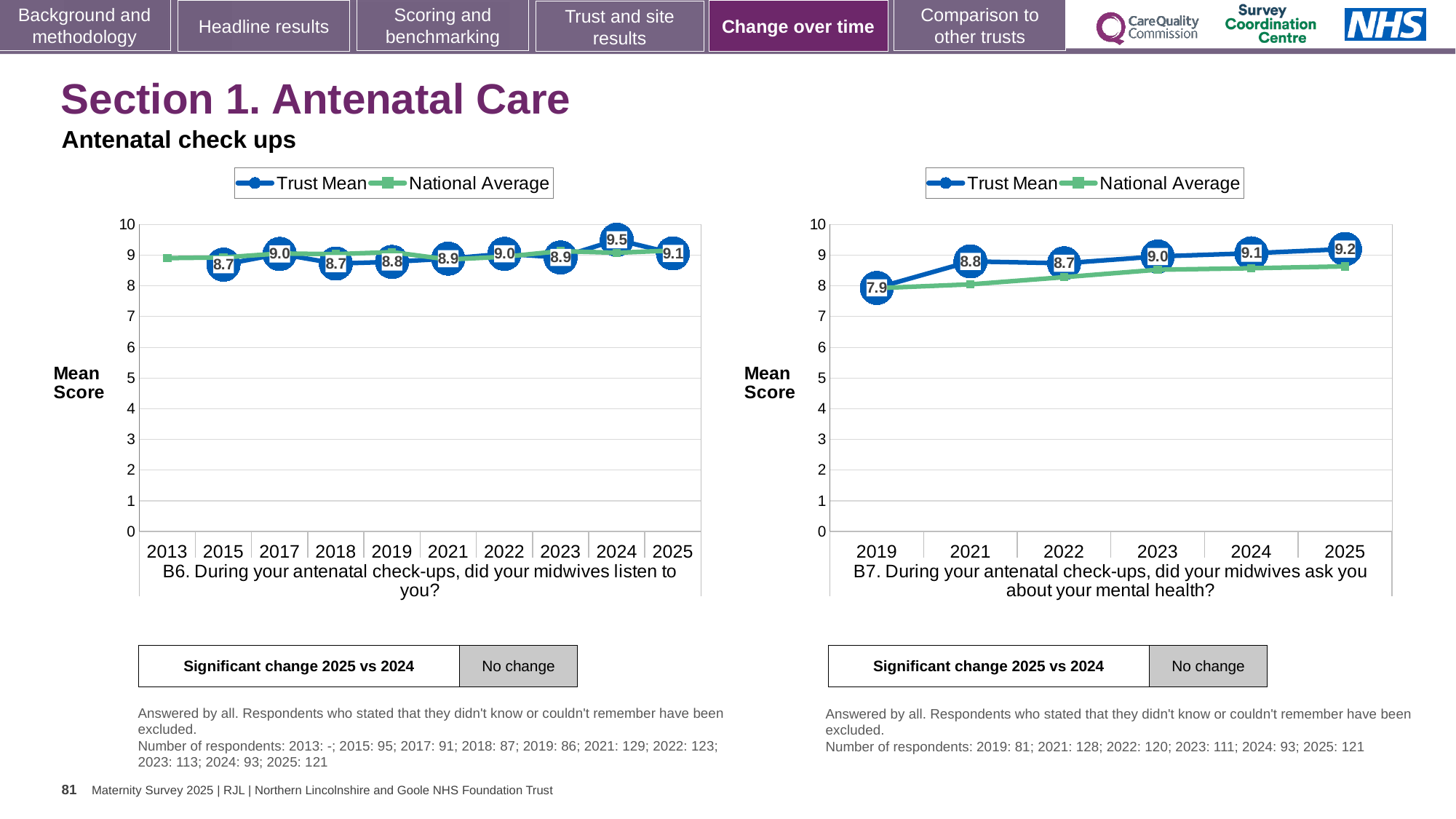
How many series does the legend of the B6 chart on the left list? 2 In the B7 chart on the right, does the Trust Mean generally rise or fall from 2019 to 2025? rise In the B7 chart on the right, which year has the lowest Trust Mean? 2019 What kind of chart is the B7 chart on the right? line chart In the B6 chart on the left, which year has the highest Trust Mean? 2024 In the B7 chart on the right, what is the Trust Mean for 2019? 7.9 In the B7 chart on the right, is the National Average for 2025 greater or less than 9? less In the B6 chart on the left, what is the Trust Mean for 2024? 9.5 In the B6 chart on the left, what is the difference between the Trust Mean for 2024 and for 2025? 0.4 In the B7 chart on the right, what is the difference between the Trust Mean for 2025 and for 2019? 1.3 How many years are shown on the x axis of the B7 chart on the right? 6 In the B7 chart on the right, is the Trust Mean or the National Average higher in 2023? Trust Mean